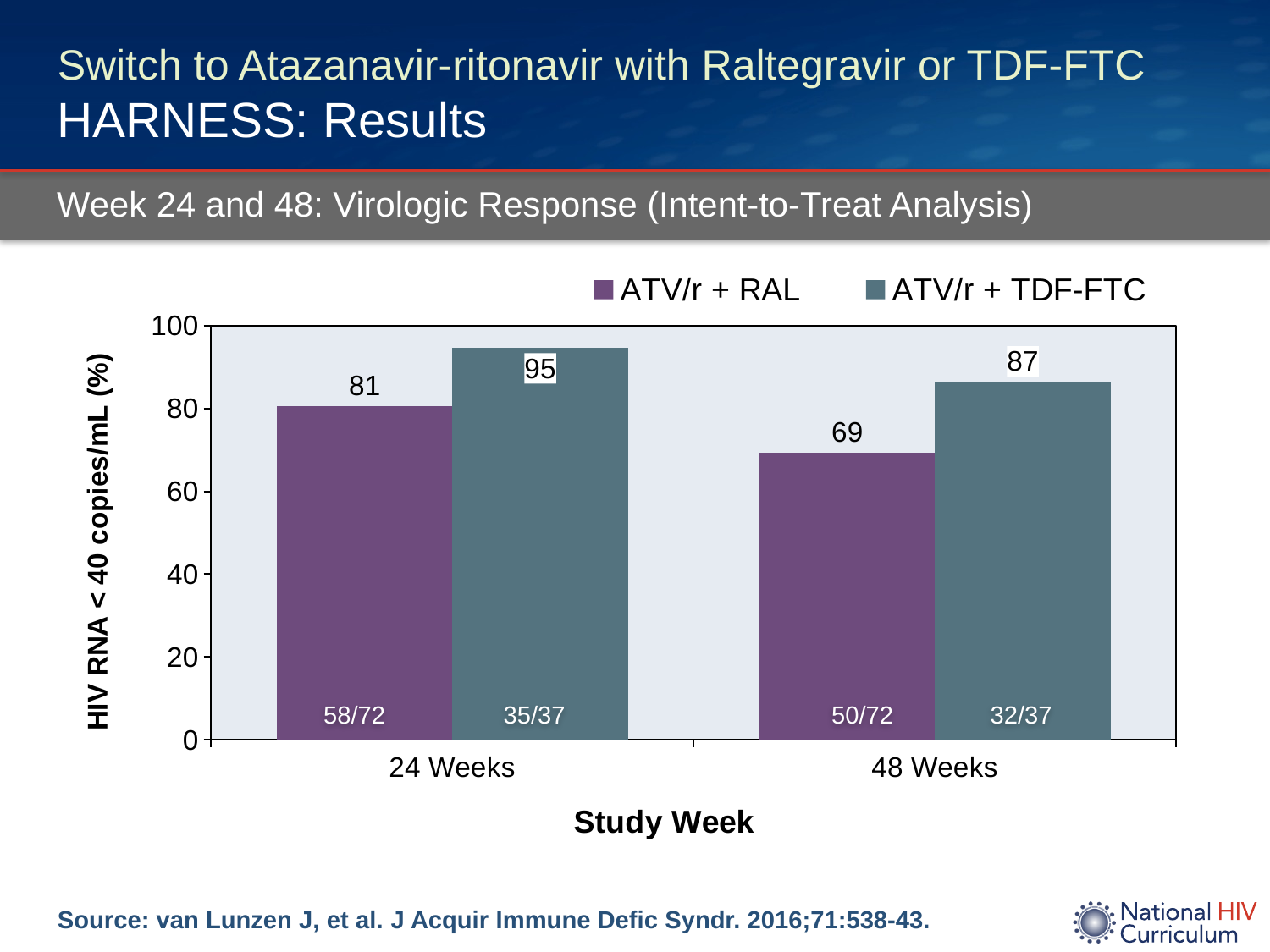
Which bar has the lowest value on the chart? ATV/r + RAL at 48 Weeks What is the value for ATV/r + RAL at 48 Weeks? 69 Which is larger at 48 Weeks, ATV/r + RAL or ATV/r + TDF-FTC? ATV/r + TDF-FTC Which bar has the highest value on the chart? ATV/r + TDF-FTC at 24 Weeks What is the value for ATV/r + RAL at 24 Weeks? 81 What fraction label is shown inside the ATV/r + RAL bar at 48 Weeks? 50/72 What is the value for ATV/r + TDF-FTC at 24 Weeks? 95 What is the value for ATV/r + TDF-FTC at 48 Weeks? 87 What kind of chart is shown on the slide? Bar chart How many study week categories are shown on the x axis? 2 What is the difference between ATV/r + TDF-FTC and ATV/r + RAL at 24 Weeks? 14 How many series does the legend list? 2